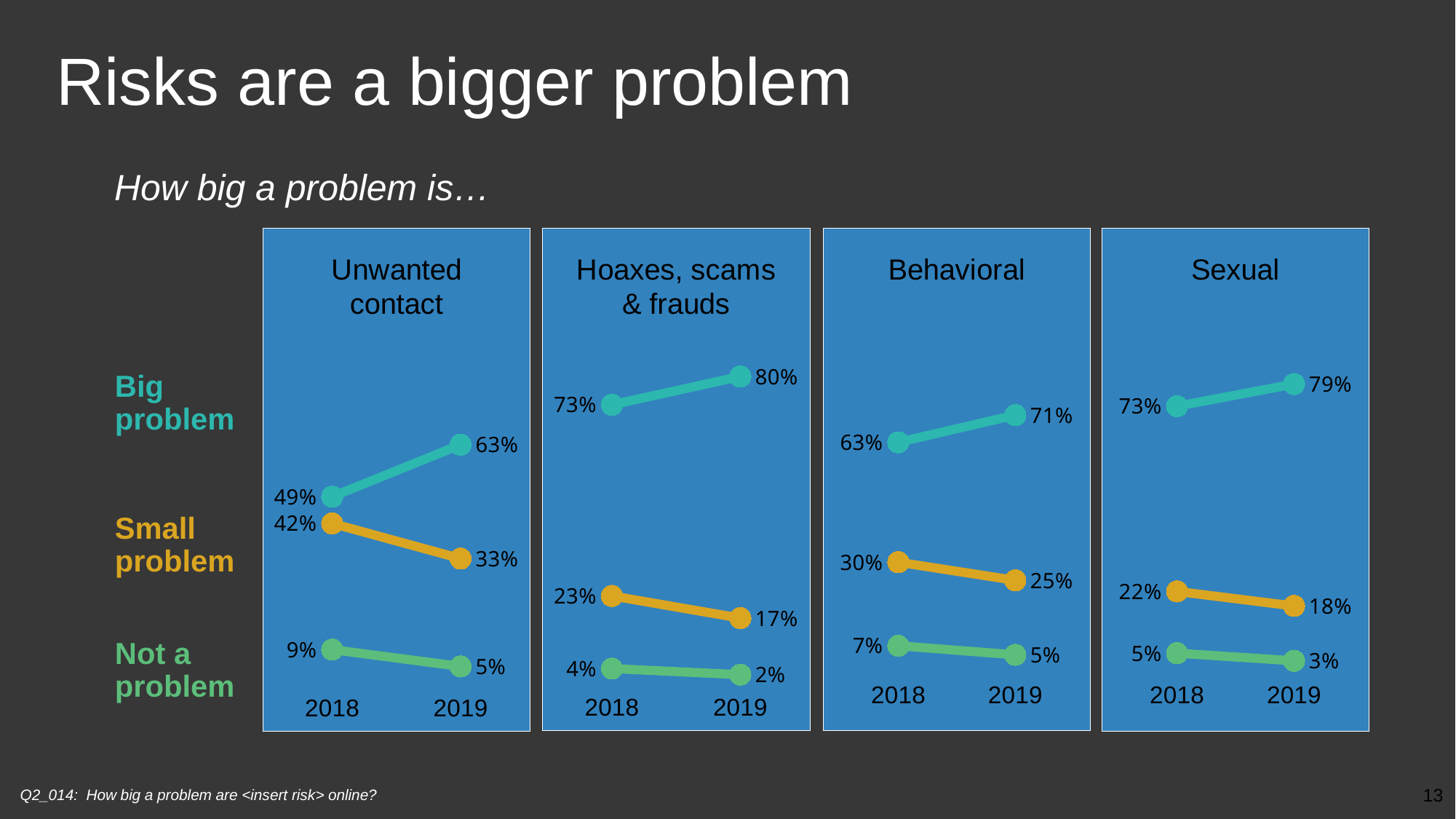
Across the four charts, which risk has the lowest not a problem value in 2019? Hoaxes, scams & frauds How many series (problem levels) are shown in each chart? 3 In the Hoaxes, scams & frauds chart, what percentage said it was a small problem in 2018? 23% In the Unwanted contact chart, by how many percentage points did the big problem value change from 2018 to 2019? 14 percentage points What type of chart is used on this slide? Line chart In the Behavioral chart, what percentage said it was not a problem in 2019? 5% In the Hoaxes, scams & frauds chart, what is the difference between the big problem and small problem values in 2019? 63 percentage points Across the four charts, which risk has the highest big problem value in 2019? Hoaxes, scams & frauds In the Sexual chart, does the small problem value rise or fall from 2018 to 2019? Fall In the Unwanted contact chart, what percentage said it was a big problem in 2019? 63% In the Behavioral chart, which is larger: the small problem value in 2018 or in 2019? 2018 In the Sexual chart, what percentage said it was a big problem in 2019? 79%